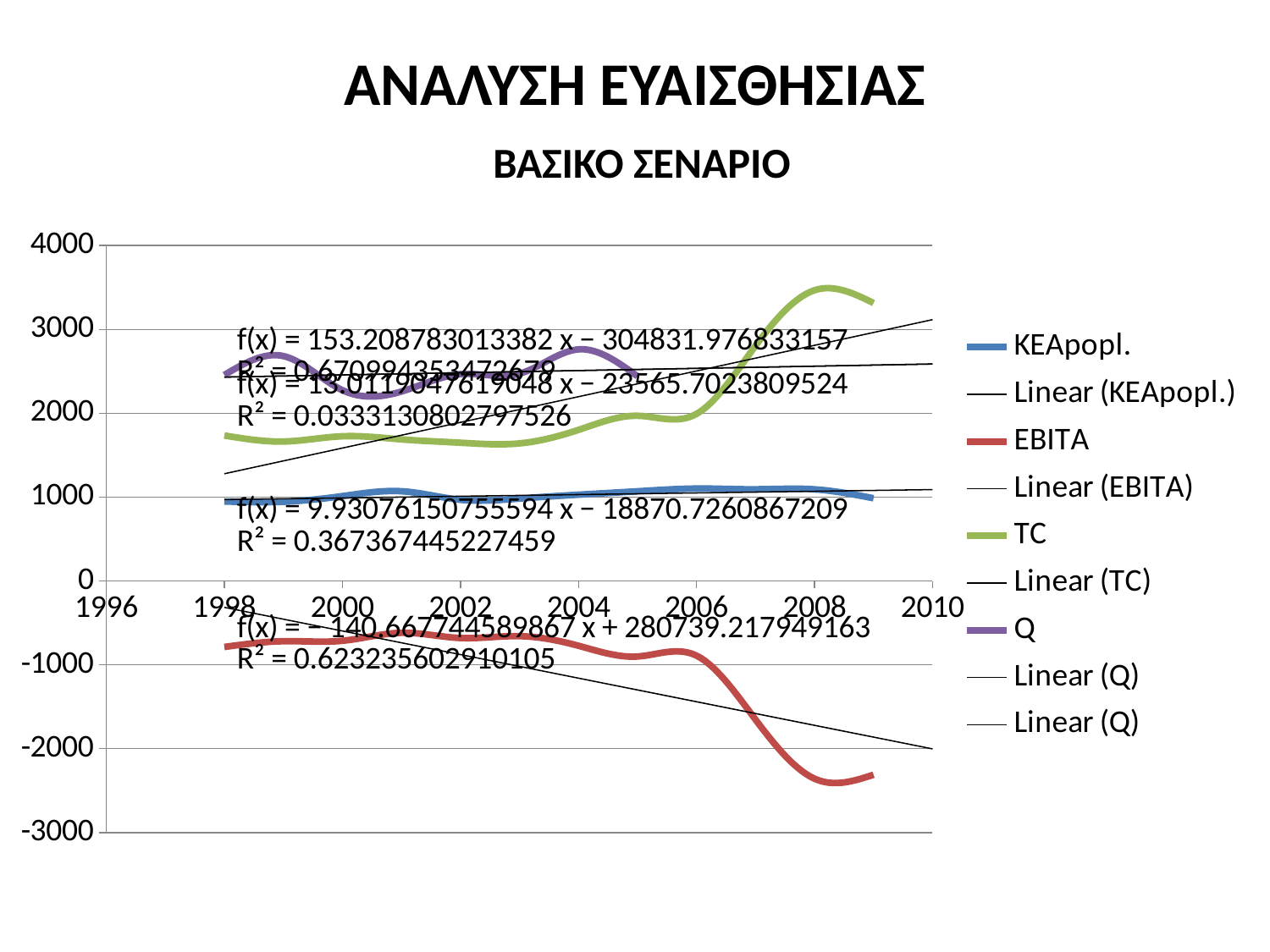
Is the value of TC in 2008 greater or less than 3000? greater Does the TC series rise or fall overall from 1998 to 2009? rise Which series has the highest value in 2008? TC What is the title of the chart? ΒΑΣΙΚΟ ΣΕΝΑΡΙΟ Is the value of Q in 2004 greater or less than 2000? greater Which series has the lowest value in 2008? EBITA Is the value of EBITA in 2008 greater or less than -2000? less Which is larger in 2000, Q or KEApopl.? Q What kind of chart is shown on the slide? line chart Does the EBITA series rise or fall overall from 1998 to 2009? fall How many entries does the chart legend list? 9